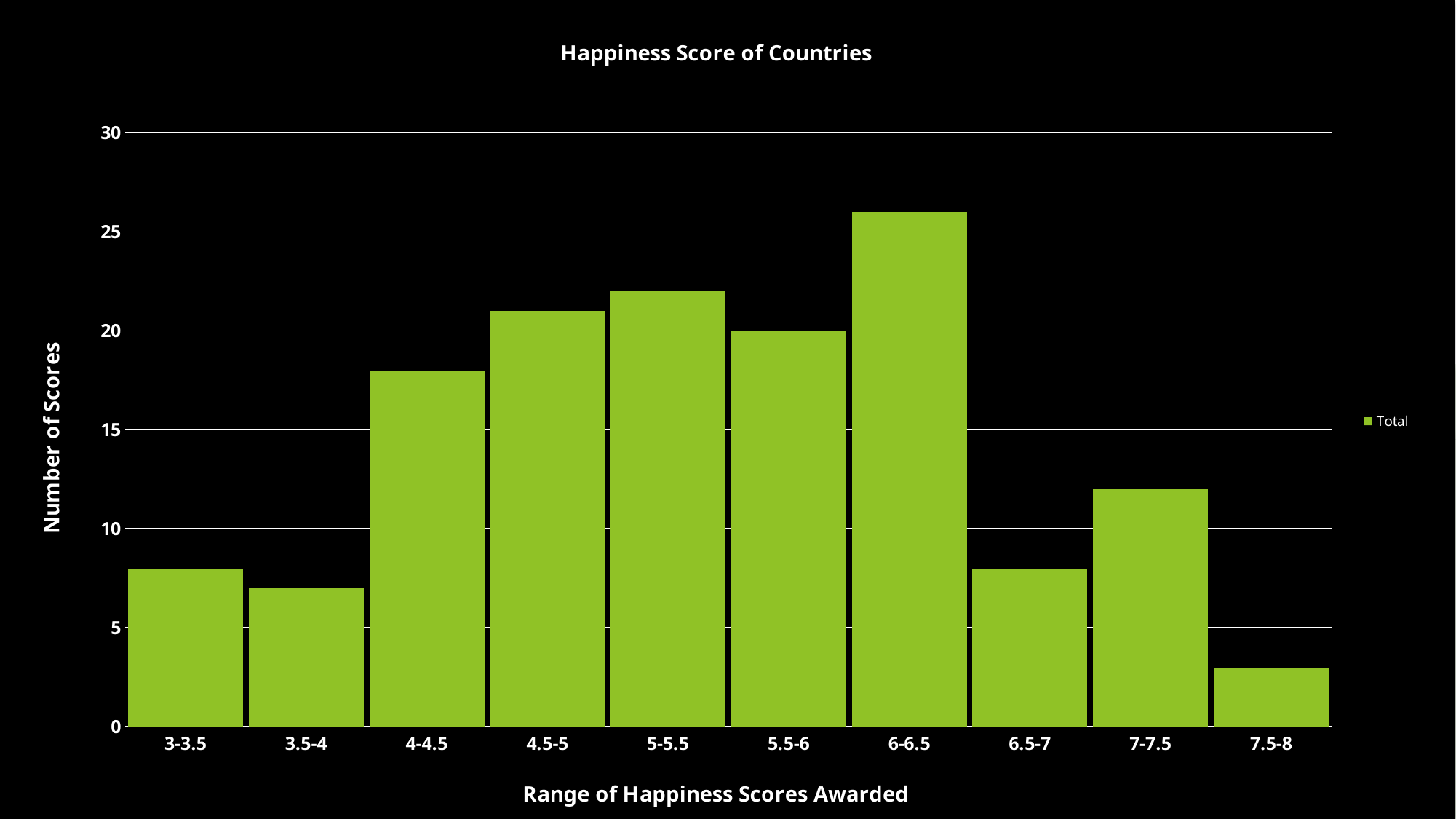
What is the number of scores for the 5.5-6 range? 20 Which score range has the highest number of scores? 6-6.5 Which has more scores, the 4-4.5 range or the 7-7.5 range? 4-4.5 How many score ranges (categories) are shown on the x axis? 10 Is the value for the 7.5-8 range greater or less than 5? less What type of chart is shown on the slide? bar chart How many series does the legend list? 1 Is the value for the 6-6.5 range greater or less than 25? greater Which score range has the lowest number of scores? 7.5-8 Is the value for the 4-4.5 range greater or less than 15? greater What is the title of the chart? Happiness Score of Countries